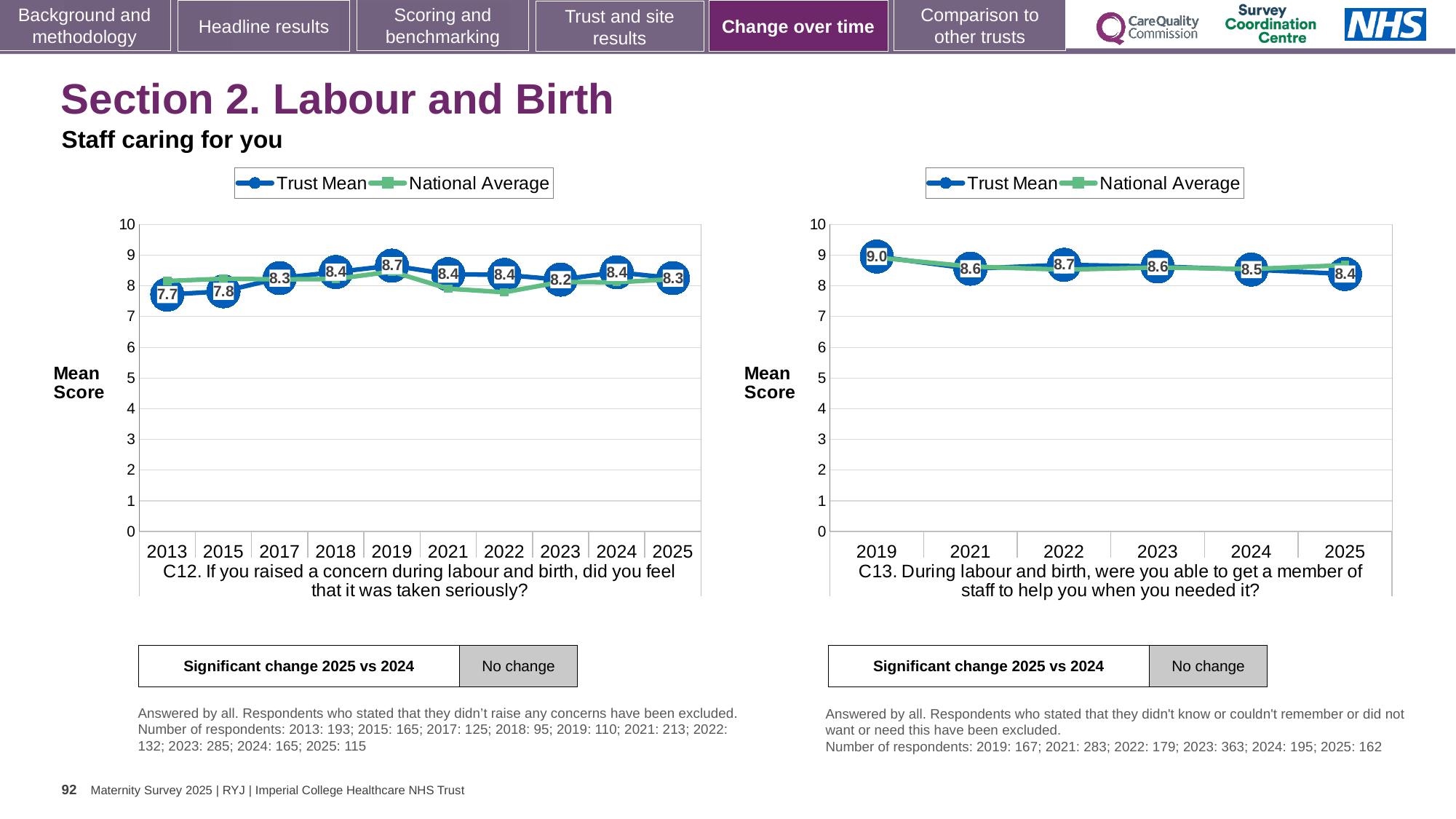
On the right chart (C13), what is the Trust Mean for 2025? 8.4 On the left chart (C12), how many years are plotted on the x axis? 10 On the left chart (C12), which year has the lowest Trust Mean? 2013 On the right chart (C13), does the Trust Mean generally rise or fall from 2019 to 2025? fall On the left chart (C12), what is the difference between the Trust Mean for 2019 and the Trust Mean for 2013? 1.0 What kind of chart is the left chart (C12)? line chart On the left chart (C12), what is the Trust Mean for 2019? 8.7 On the right chart (C13), what is the Trust Mean for 2019? 9.0 On the left chart (C12), what is the Trust Mean for 2013? 7.7 On the right chart (C13), which year has the lowest Trust Mean? 2025 On the right chart (C13), how many series does the legend list? 2 On the left chart (C12), which year has the highest Trust Mean? 2019